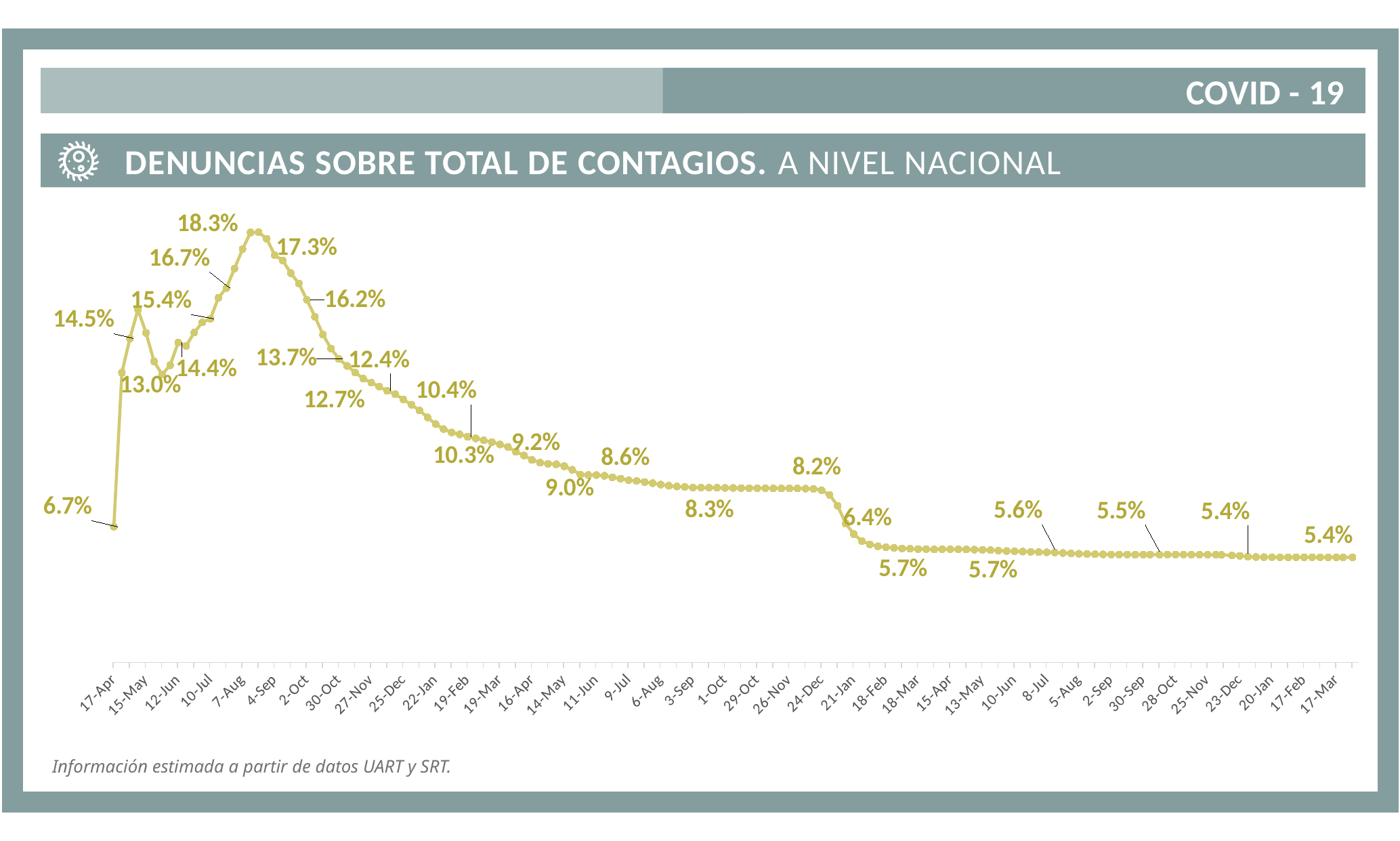
What is the value at the last point of the line (17-Mar)? 5.4% What is the title of the chart? DENUNCIAS SOBRE TOTAL DE CONTAGIOS. A NIVEL NACIONAL What is the difference between the peak value (18.3%) and the first value (6.7%)? 11.6 percentage points What is the difference between the peak value (18.3%) and the final value (5.4%)? 12.9 percentage points Which is larger, the labelled value 14.5% near the start or the labelled value 15.4% shortly after it? 15.4% What is the value at the first point of the line (17-Apr)? 6.7% Do the values rise or fall along the x axis from the peak around 4-Sep to 17-Mar? fall What source note appears below the chart? Información estimada a partir de datos UART y SRT. What kind of chart is shown on the slide? line chart What is the highest value labelled on the line? 18.3% What is the lowest value labelled on the line? 5.4% How many lines (series) are plotted on the chart? 1